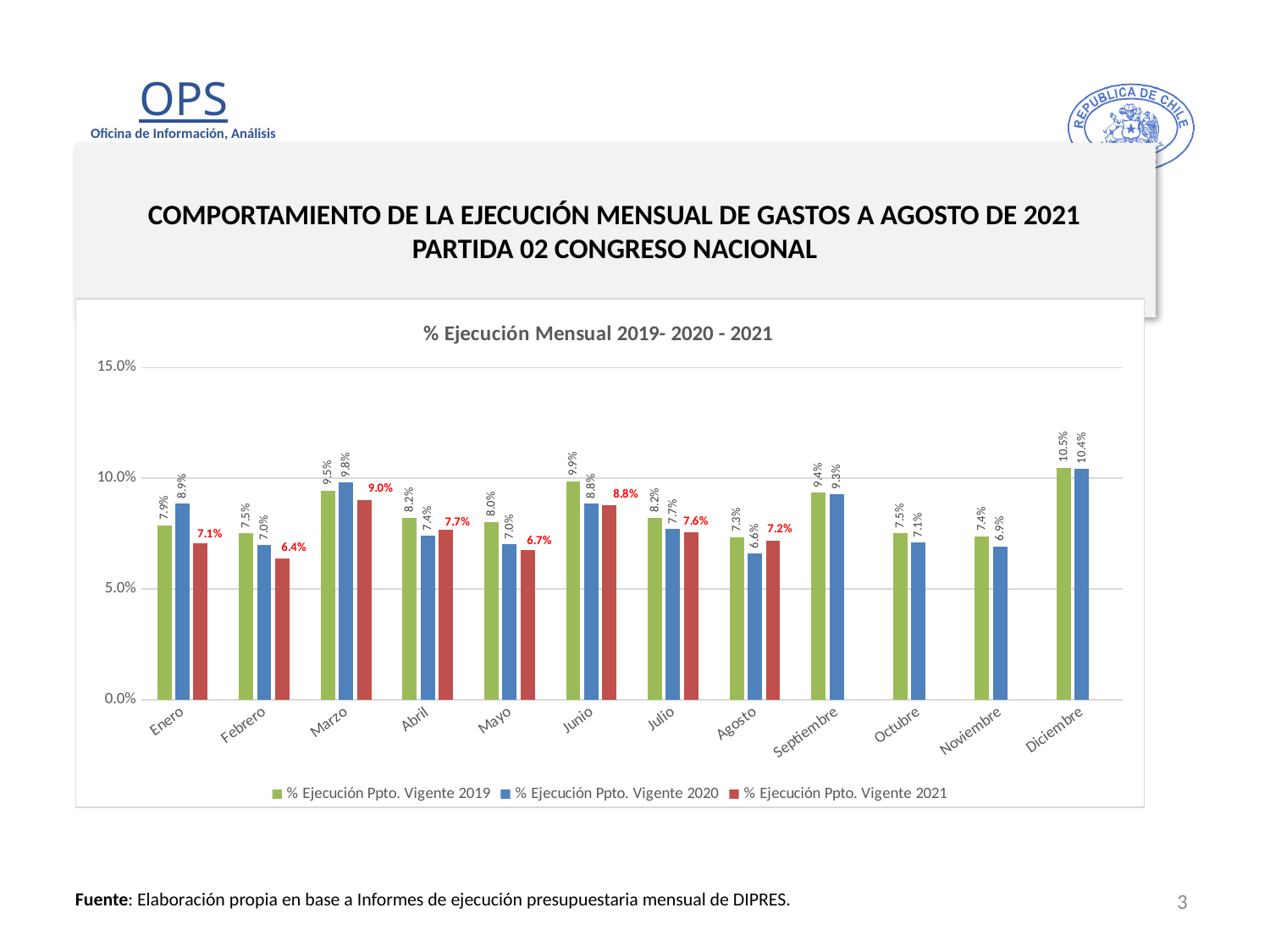
Is the value for % Ejecución Ppto. Vigente 2020 in Diciembre greater or less than 10.0%? greater How many series does the legend list? 3 Which is larger in Abril: the 2020 value or the 2021 value? 2021 value (7.7%) What is the difference between the 2019 and 2021 values in Junio? 1.1% How many months have a value plotted for % Ejecución Ppto. Vigente 2021? 8 What is the title of the chart? % Ejecución Mensual 2019- 2020 - 2021 Which month has the highest value for % Ejecución Ppto. Vigente 2019? Diciembre What is the value for % Ejecución Ppto. Vigente 2021 in Marzo? 9.0% What kind of chart is shown on the slide? Bar chart What is the value for % Ejecución Ppto. Vigente 2019 in Diciembre? 10.5% Which month has the lowest value for % Ejecución Ppto. Vigente 2021? Febrero What is the value for % Ejecución Ppto. Vigente 2020 in Enero? 8.9%